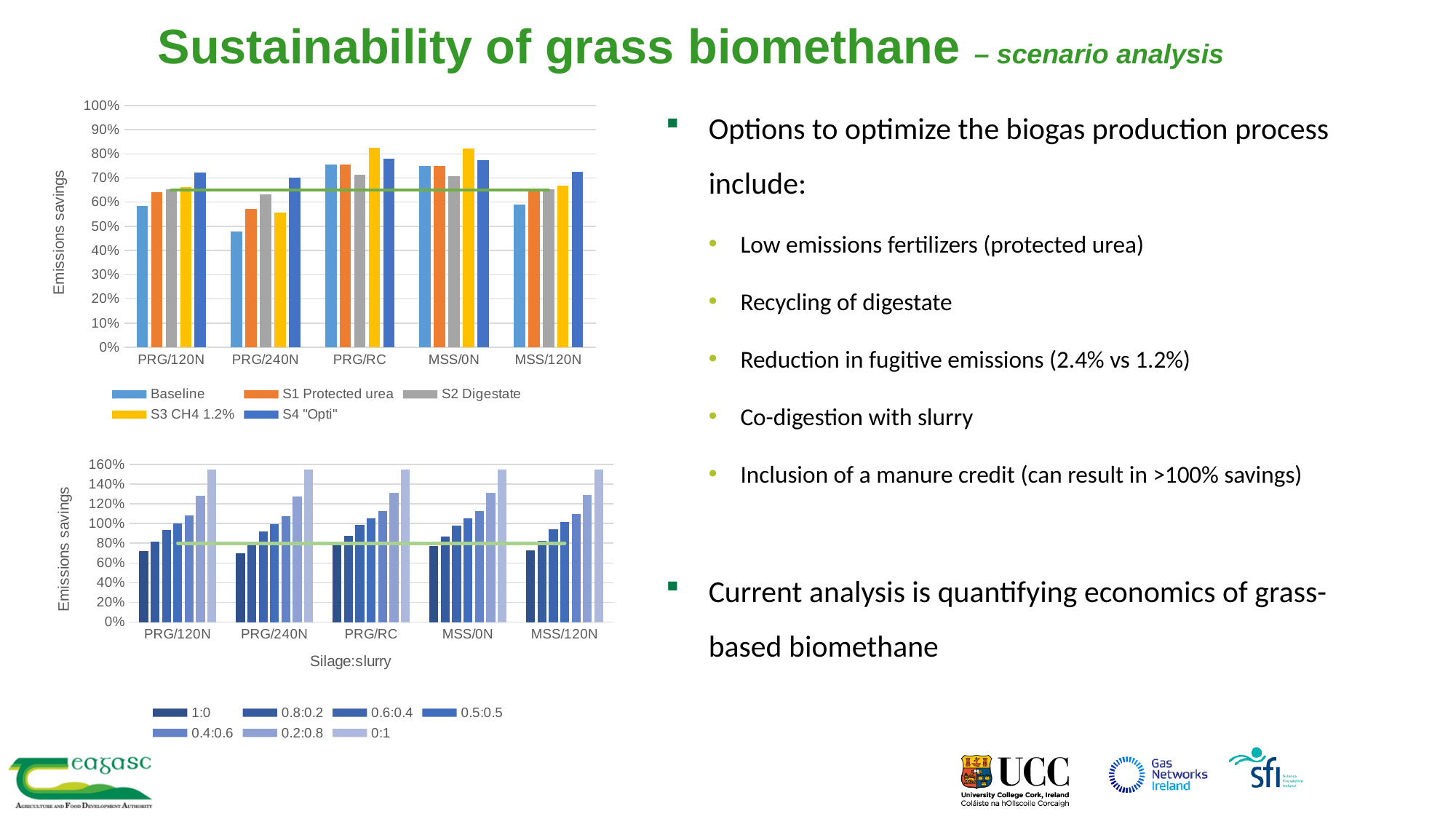
How many categories are shown on the x axis of the top chart? 5 How many series does the legend of the bottom chart list? 7 How many series does the legend of the top chart list? 5 In the top chart, which is larger: the Baseline value for PRG/RC or the Baseline value for PRG/240N? PRG/RC In the bottom chart, is the 0:1 value for PRG/120N greater or less than 140%? greater What kind of chart is the top chart on the slide? bar chart In the top chart, is the S3 CH4 1.2% value for PRG/RC greater or less than 80%? greater What is the x-axis title of the bottom chart? Silage:slurry In the top chart, which category has the lowest Baseline value? PRG/240N In the bottom chart, within each category, do the values rise or fall going from the 1:0 series to the 0:1 series? rise In the bottom chart, is the 1:0 value for PRG/240N greater or less than 80%? less